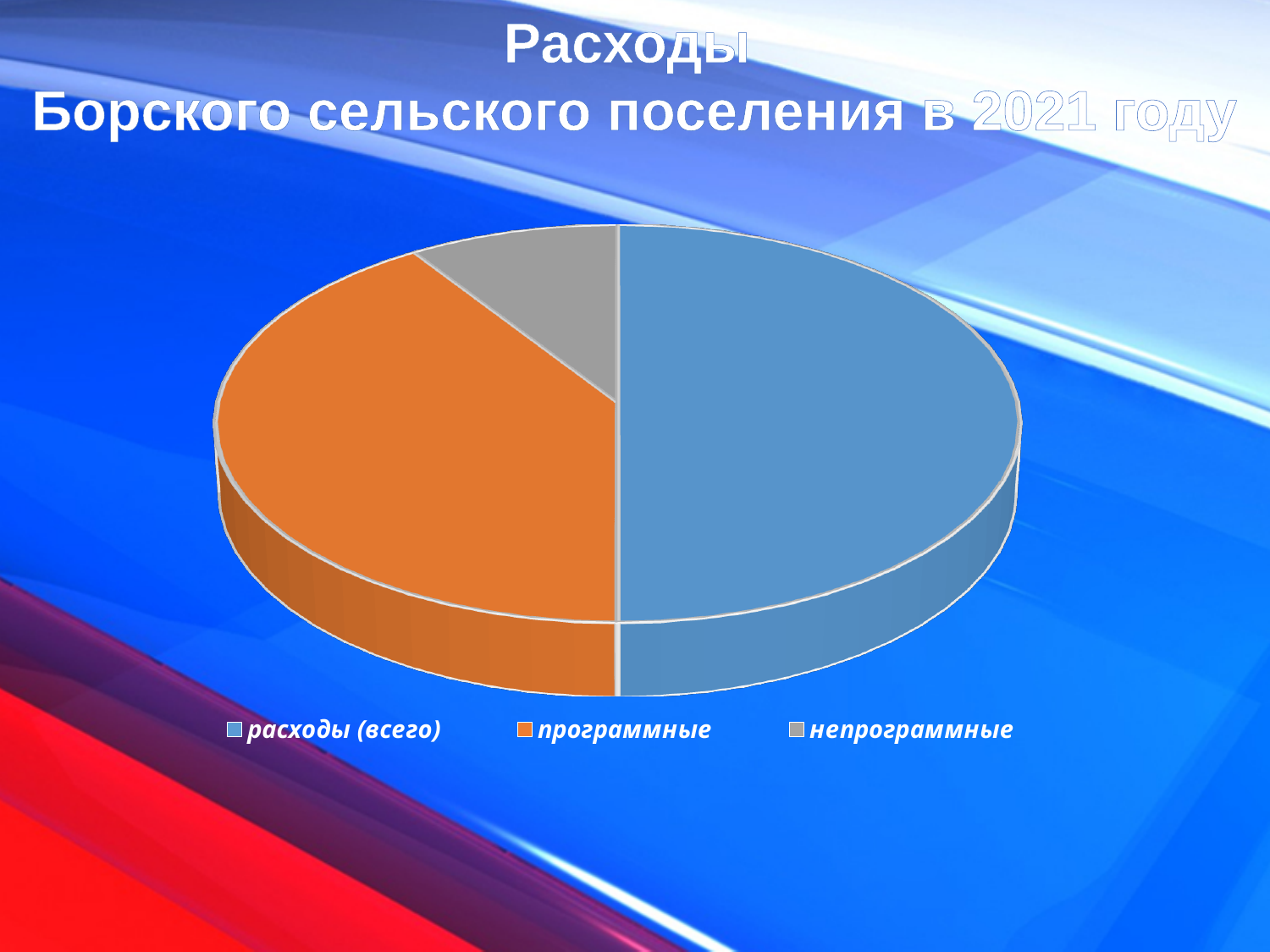
Which category has the smallest slice of the pie? непрограммные Which slice is larger: расходы (всего) or непрограммные? расходы (всего) Which slice is larger: программные or непрограммные? программные Which category has the largest slice of the pie? расходы (всего) How many entries does the legend list? 3 What is the title of the slide? Расходы Борского сельского поселения в 2021 году What kind of chart is shown on the slide? pie chart Which slice is larger: расходы (всего) or программные? расходы (всего) How many slices does the pie chart have? 3 What colour is the slice for непрограммные? grey